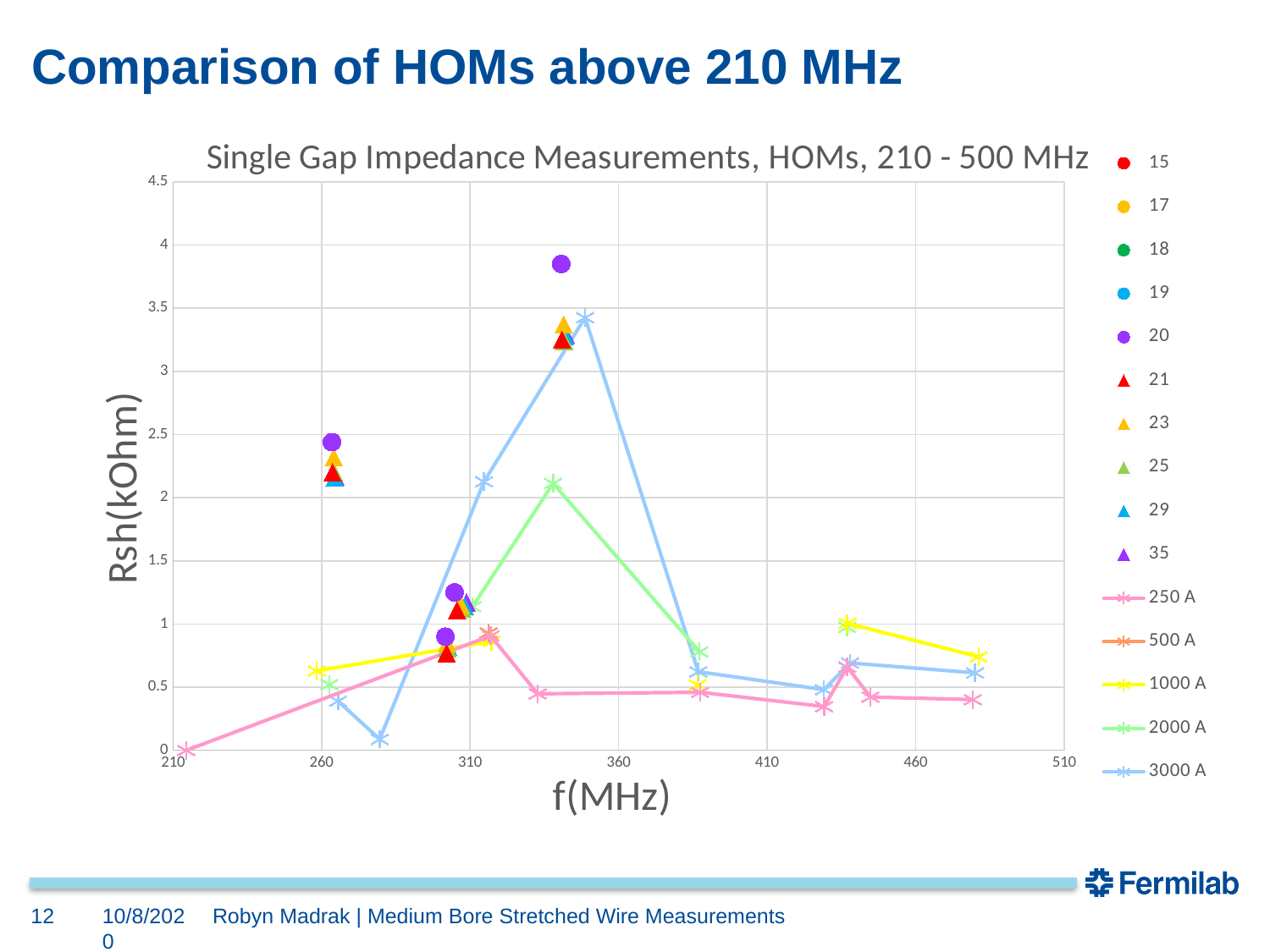
How many series does the legend list? 15 What is the title of the chart? Single Gap Impedance Measurements, HOMs, 210 - 500 MHz Which series reaches the highest Rsh value on the chart? 20 Which is larger: the peak of the 3000 A series or the peak of the 2000 A series? 3000 A Is the value of the 250 A series at 210 MHz greater or less than 0.5 kOhm? less Is the highest point of series 20 greater or less than 3.5 kOhm? greater Is the value of series 20 near 265 MHz greater or less than 2 kOhm? greater What is the label of the vertical axis? Rsh(kOhm) Which is larger: the peak of series 20 near 340 MHz or the peak of the 3000 A series near 350 MHz? series 20 What kind of chart is shown on the slide? scatter chart